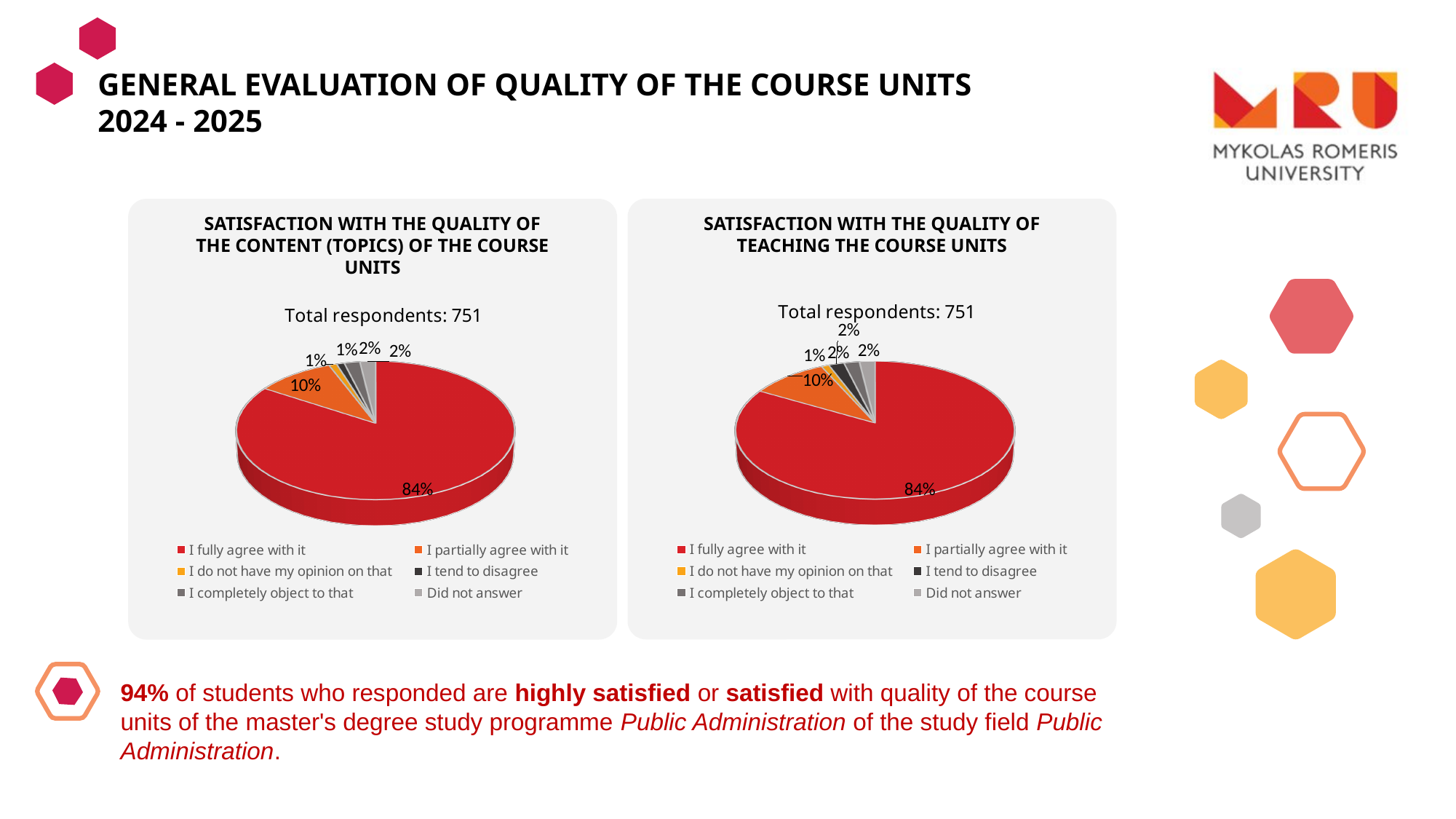
In the left chart (satisfaction with the quality of the content of the course units), what is the difference between the 'I fully agree with it' and 'I partially agree with it' shares? 74% How many response categories does the legend of the right chart (satisfaction with the quality of teaching the course units) list? 6 In the right chart (satisfaction with the quality of teaching the course units), which response category has the largest slice? I fully agree with it In the left chart (satisfaction with the quality of the content of the course units), what share of respondents partially agree? 10% In the right chart (satisfaction with the quality of teaching the course units), what share of respondents partially agree? 10% In the left chart (satisfaction with the quality of the content of the course units), which response category has the largest slice? I fully agree with it What kind of chart is used in the left panel (satisfaction with the quality of the content of the course units)? Pie chart What is the title of the right chart? Satisfaction with the quality of teaching the course units In the left chart (satisfaction with the quality of the content of the course units), what share of respondents fully agree? 84% In the right chart (satisfaction with the quality of teaching the course units), which is larger: 'I fully agree with it' or 'I partially agree with it'? I fully agree with it How many total respondents are reported for the left chart (satisfaction with the quality of the content of the course units)? 751